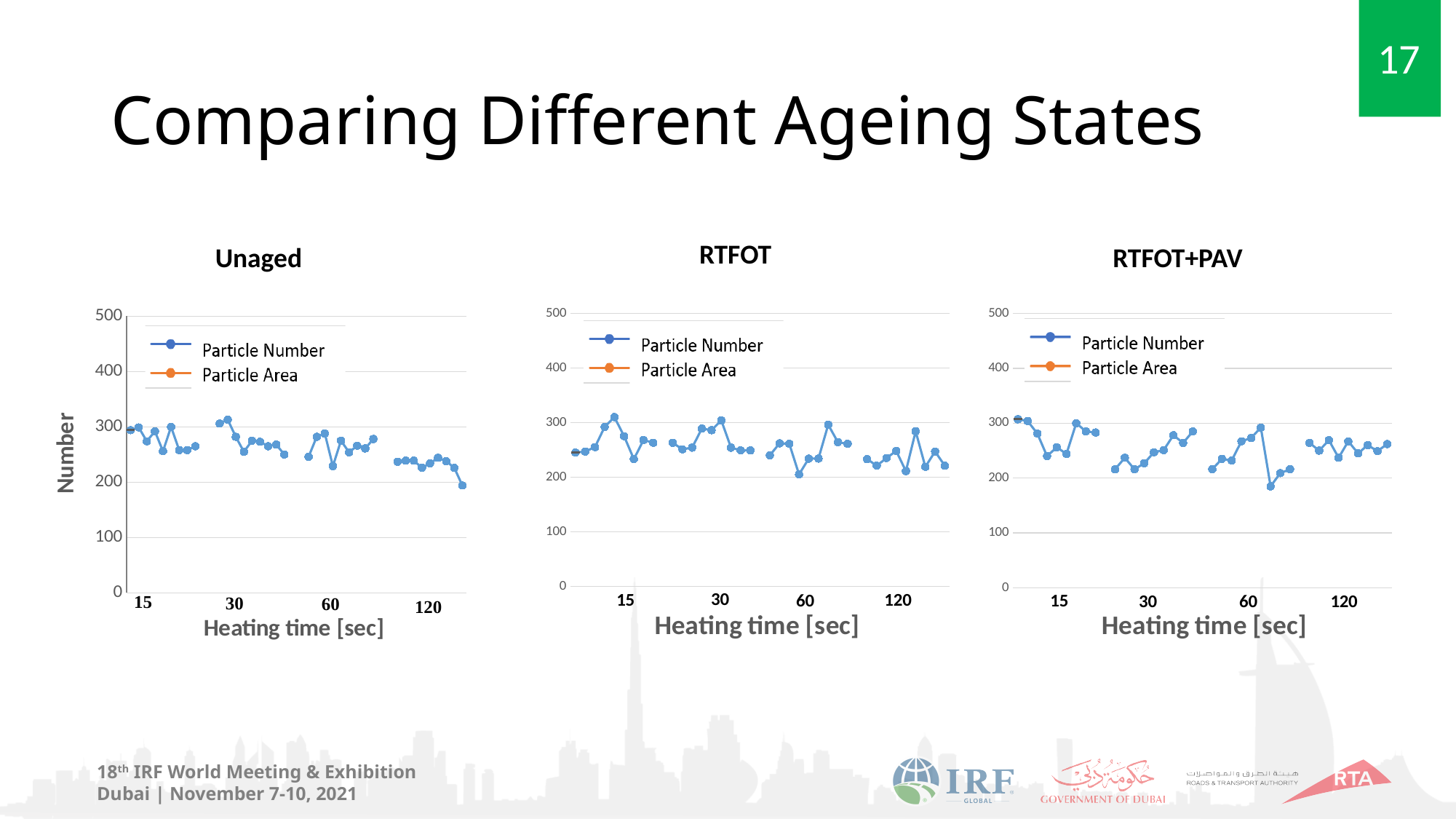
How many heating time values are labelled on the x axis of the RTFOT chart? 4 In the RTFOT chart, is the highest Particle Number value greater or less than 400? less What kind of chart is the Unaged chart? line chart In the Unaged chart, which heating time group has lower Particle Number values overall, 15 sec or 120 sec? 120 sec In the RTFOT+PAV chart, is the lowest Particle Number value in the 60 sec group greater or less than 200? less In the Unaged chart, does the Particle Number generally rise or fall as heating time increases from 15 to 120 sec? fall What is the x-axis label on the RTFOT+PAV chart? Heating time [sec] How many series does the legend of the RTFOT chart list? 2 How many charts are shown on the slide? 3 In the Unaged chart, is the highest Particle Number value greater or less than 400? less What is the y-axis label on the Unaged chart? Number